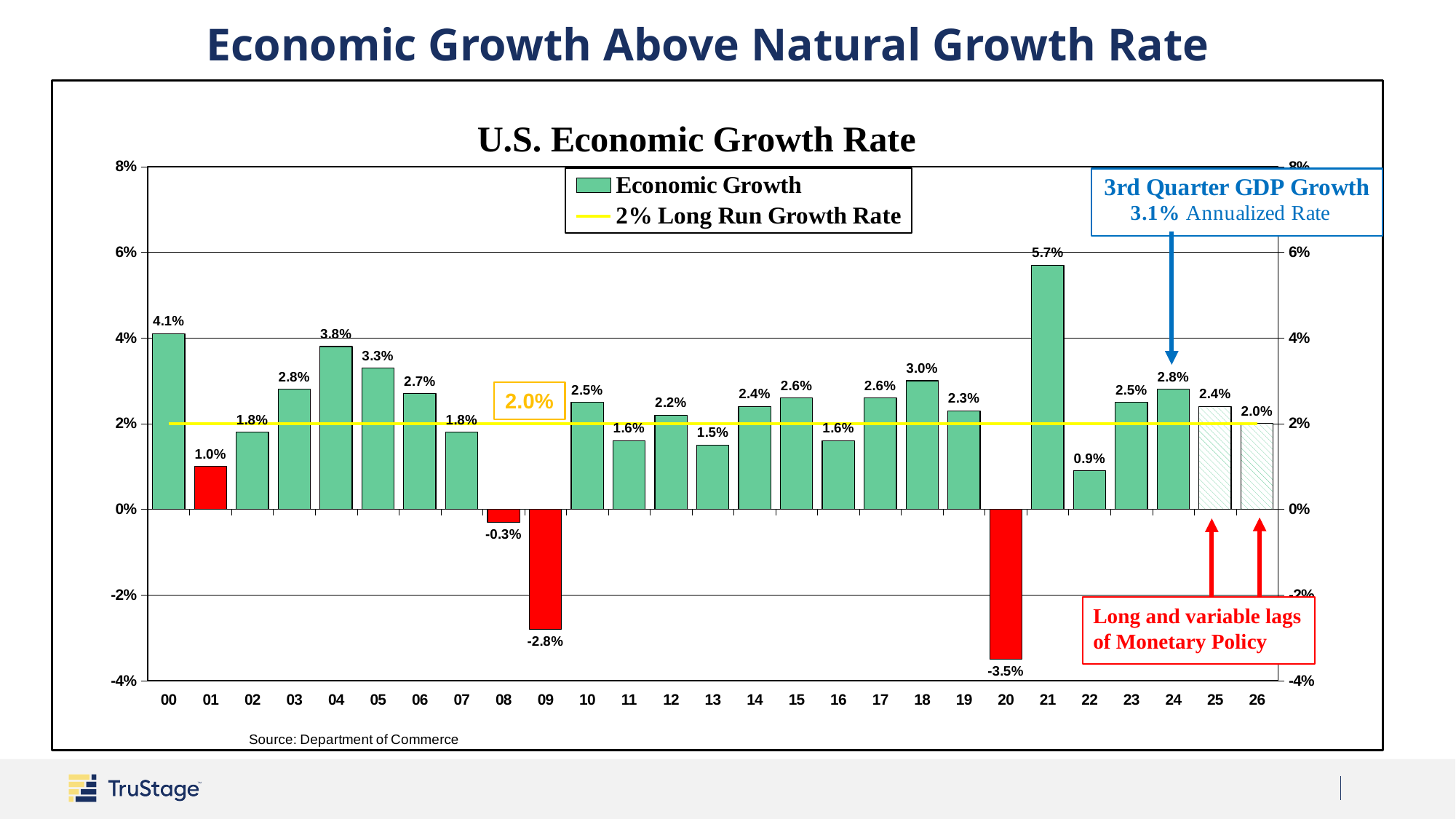
How many entries does the legend list? 2 What is the economic growth rate shown for 2009? -2.8% Is the economic growth rate for 2018 greater or less than 2%? greater How many years are shown on the x axis? 27 Which year has the lowest economic growth rate? 20 What is the difference between the economic growth rate in 2021 and in 2022? 4.8% What is the title of the chart? U.S. Economic Growth Rate What is the economic growth rate shown for 2024? 2.8% Which year has the highest economic growth rate? 21 What kind of chart is used to show the U.S. economic growth rate? Bar chart What is the economic growth rate shown for 2021? 5.7% Which year has a higher economic growth rate, 2004 or 2005? 04